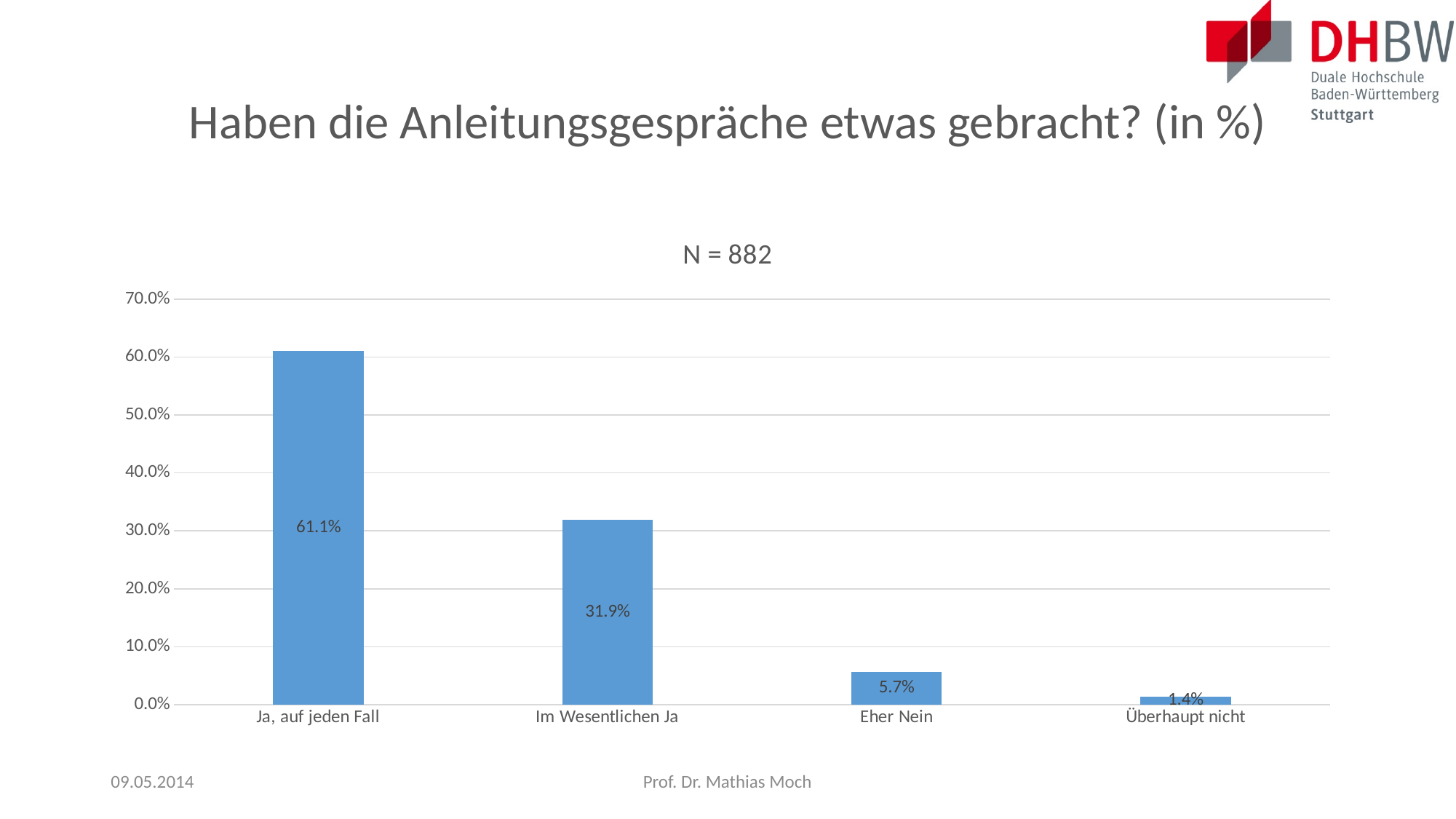
What is the chart's title shown above the plot area? N = 882 What is the value for "Ja, auf jeden Fall"? 61.1% Which category has the highest value? Ja, auf jeden Fall Is the value for "Im Wesentlichen Ja" greater or less than 40.0%? less What is the value for "Überhaupt nicht"? 1.4% What is the value for "Im Wesentlichen Ja"? 31.9% What is the difference between the values for "Ja, auf jeden Fall" and "Im Wesentlichen Ja"? 29.2% How many categories are shown on the x axis? 4 Which category has the lowest value? Überhaupt nicht What kind of chart is shown on the slide? bar chart Which is larger, the value for "Eher Nein" or the value for "Überhaupt nicht"? Eher Nein What is the value for "Eher Nein"? 5.7%